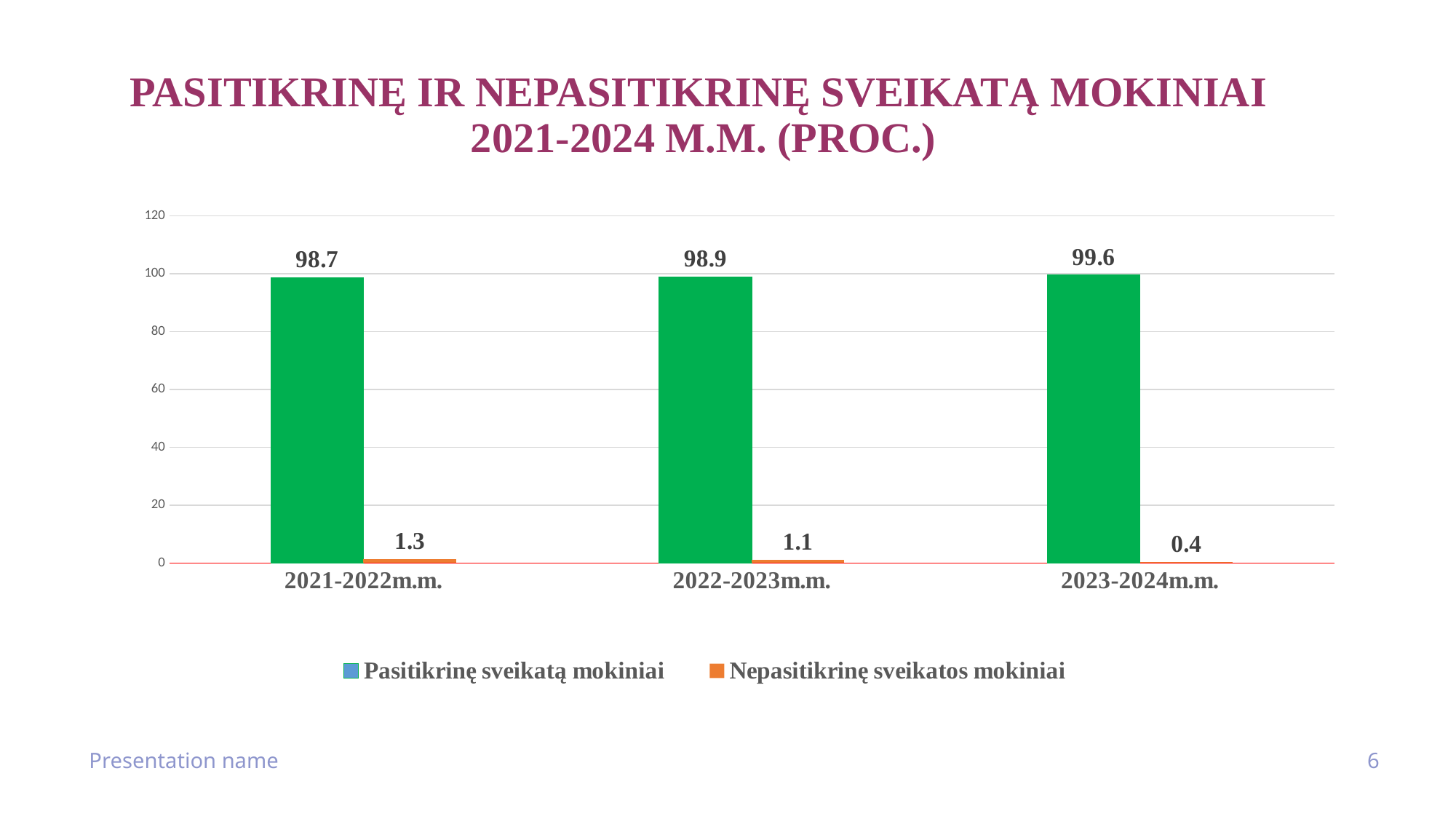
What kind of chart is shown on the slide? bar chart What is the value for Nepasitikrinę sveikatos mokiniai in 2023-2024m.m.? 0.4 What is the value for Nepasitikrinę sveikatos mokiniai in 2022-2023m.m.? 1.1 Which is larger: the Nepasitikrinę sveikatos mokiniai value for 2021-2022m.m. or for 2022-2023m.m.? 2021-2022m.m. How many series does the legend list? 2 How many school years are shown on the x axis? 3 In which school year is the value for Nepasitikrinę sveikatos mokiniai lowest? 2023-2024m.m. Do the values for Pasitikrinę sveikatą mokiniai rise or fall from 2021-2022m.m. to 2023-2024m.m.? rise In which school year is the value for Pasitikrinę sveikatą mokiniai highest? 2023-2024m.m. What is the difference between the Pasitikrinę sveikatą mokiniai values for 2023-2024m.m. and 2021-2022m.m.? 0.9 Is the value for Pasitikrinę sveikatą mokiniai in 2022-2023m.m. greater or less than 80? greater What is the value for Pasitikrinę sveikatą mokiniai in 2021-2022m.m.? 98.7